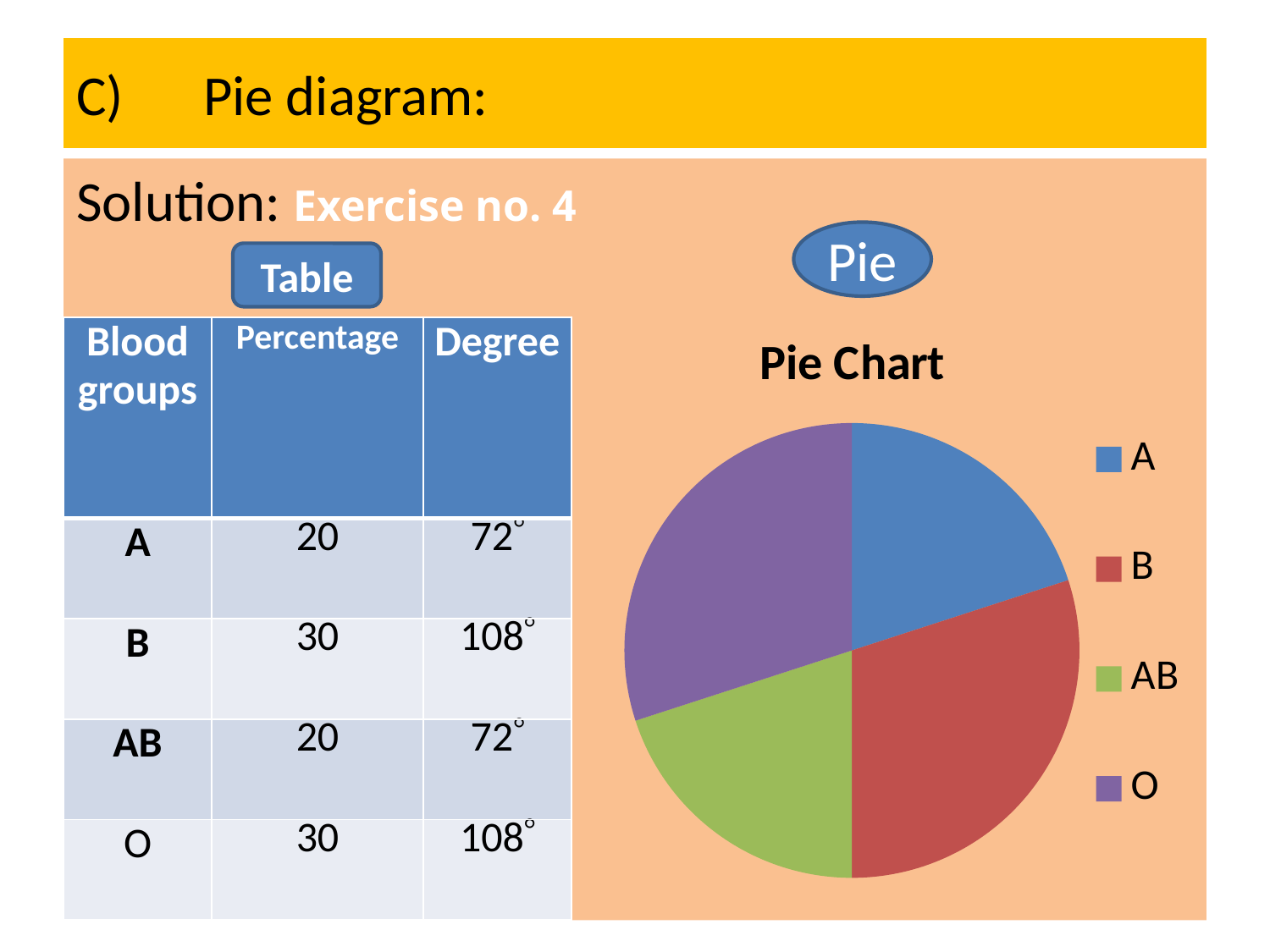
How many slices does the pie chart have? 4 Which blood group is shown in blue in the pie chart? A What kind of chart is shown on the slide? pie chart According to the table on the slide, how many degrees does the slice for blood group O occupy in the pie chart? 108° In the pie chart, which slice is larger, AB or O? O According to the table on the slide, what percentage share does blood group A have in the pie chart? 20 In the pie chart, which slice is larger, B or A? B In the pie chart, which slice is larger, B or AB? B What is the title of the chart on the slide? Pie Chart How many entries does the legend of the pie chart list? 4 According to the table on the slide, what percentage share does blood group B have in the pie chart? 30 According to the table on the slide, what is the difference in percentage between blood groups B and AB? 10